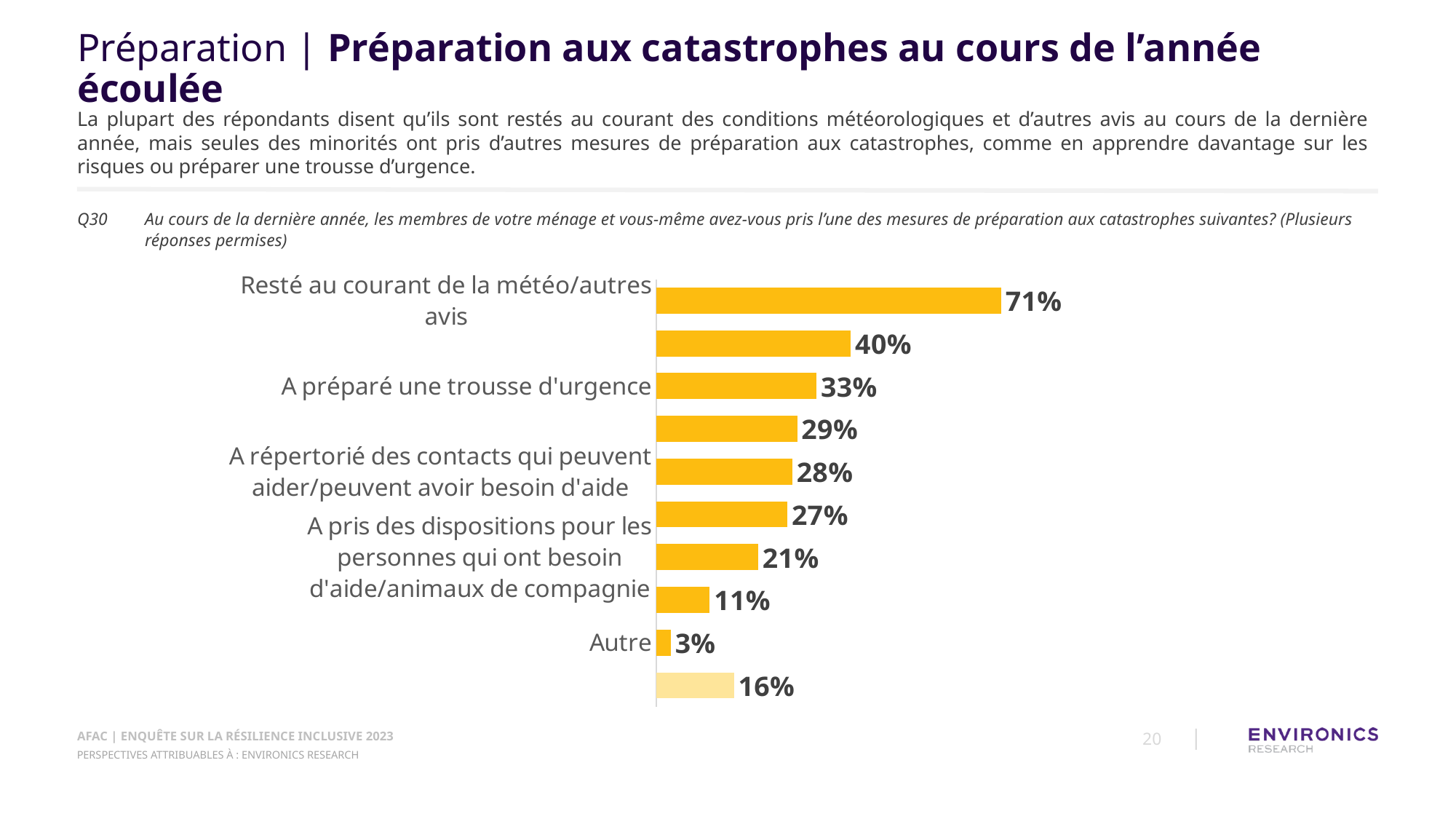
What value is shown for "A préparé une trousse d'urgence"? 33% What value is shown for "Autre"? 3% What value is shown for "Resté au courant de la météo/autres avis"? 71% What kind of chart is shown on the slide? Bar chart Which is larger: the value for "A préparé une trousse d'urgence" or the value for "A pris des dispositions pour les personnes qui ont besoin d'aide/animaux de compagnie"? A préparé une trousse d'urgence What value is shown for "A répertorié des contacts qui peuvent aider/peuvent avoir besoin d'aide"? 28% Which category has the lowest value in the chart? Autre What is the value of the bar drawn in a lighter colour at the bottom of the chart? 16% What is the difference between the values for "Resté au courant de la météo/autres avis" and "A préparé une trousse d'urgence"? 38% What value is shown for "A pris des dispositions pour les personnes qui ont besoin d'aide/animaux de compagnie"? 21% How many bars are plotted in the chart? 10 Which category has the highest value in the chart? Resté au courant de la météo/autres avis